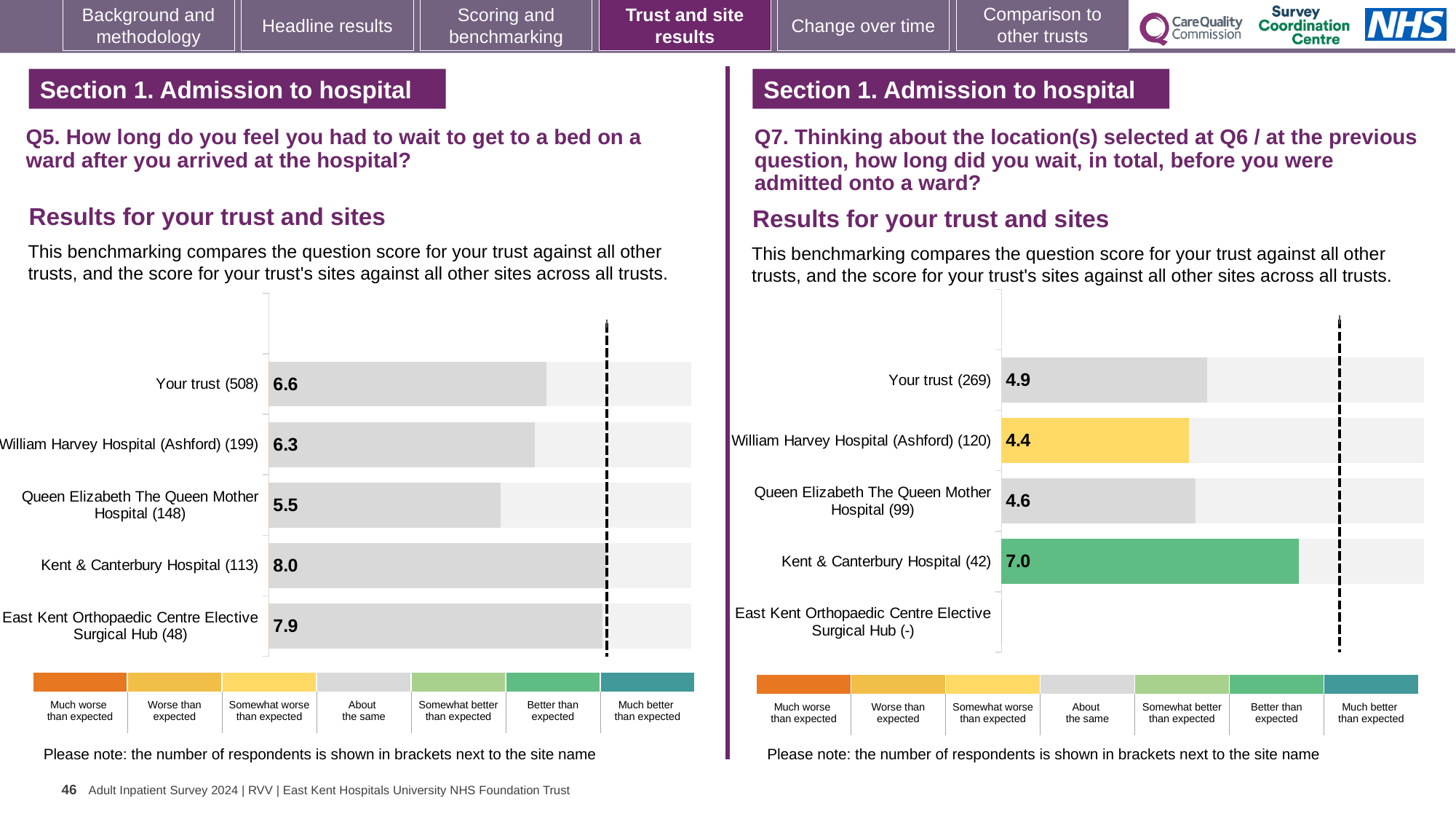
On the Q5 chart (left), which site has the lowest score? Queen Elizabeth The Queen Mother Hospital (148) On the Q5 chart (left), what is the score for Queen Elizabeth The Queen Mother Hospital (148)? 5.5 On the Q5 chart (left), how many sites or trust rows are plotted? 5 On the Q7 chart (right), what is the score for William Harvey Hospital (Ashford) (120)? 4.4 On the Q7 chart (right), which site has the lowest score? William Harvey Hospital (Ashford) (120) On the Q5 chart (left), which site has the highest score? Kent & Canterbury Hospital (113) On the Q7 chart (right), what is the difference between the scores for Kent & Canterbury Hospital and Your trust? 2.1 On the Q7 chart (right), what is the score for Kent & Canterbury Hospital (42)? 7.0 On the Q5 chart (left), what is the difference between the scores for Kent & Canterbury Hospital and William Harvey Hospital (Ashford)? 1.7 What type of chart is used on the Q5 chart (left)? Bar chart On the Q7 chart (right), which is larger: the score for Your trust or the score for Queen Elizabeth The Queen Mother Hospital? Your trust On the Q5 chart (left), what is the score for Your trust (508)? 6.6